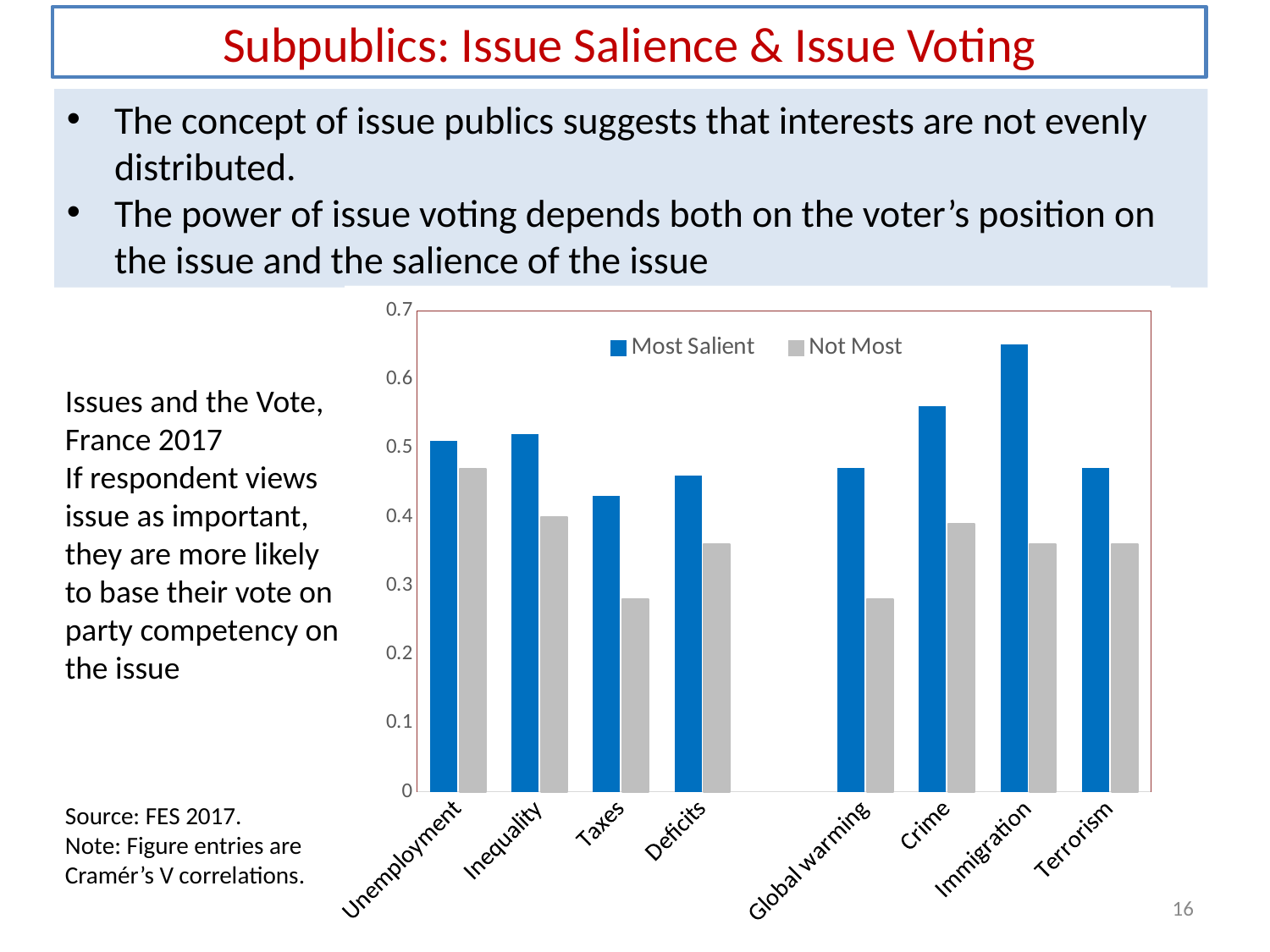
Which issue has the highest Not Most value? Unemployment What colour are the Most Salient bars in the chart? blue Is the Most Salient value for Crime greater or less than 0.5? greater Which issue has the highest Most Salient value? Immigration For Taxes, which series has the higher value, Most Salient or Not Most? Most Salient What kind of chart is shown on the slide? bar chart Is the Not Most value for Global warming greater or less than 0.3? less Is the Not Most value for Taxes greater or less than 0.3? less How many issue categories are shown on the x axis of the chart? 8 How many series does the chart's legend list? 2 Which is larger: the Most Salient value for Crime or the Most Salient value for Unemployment? Crime